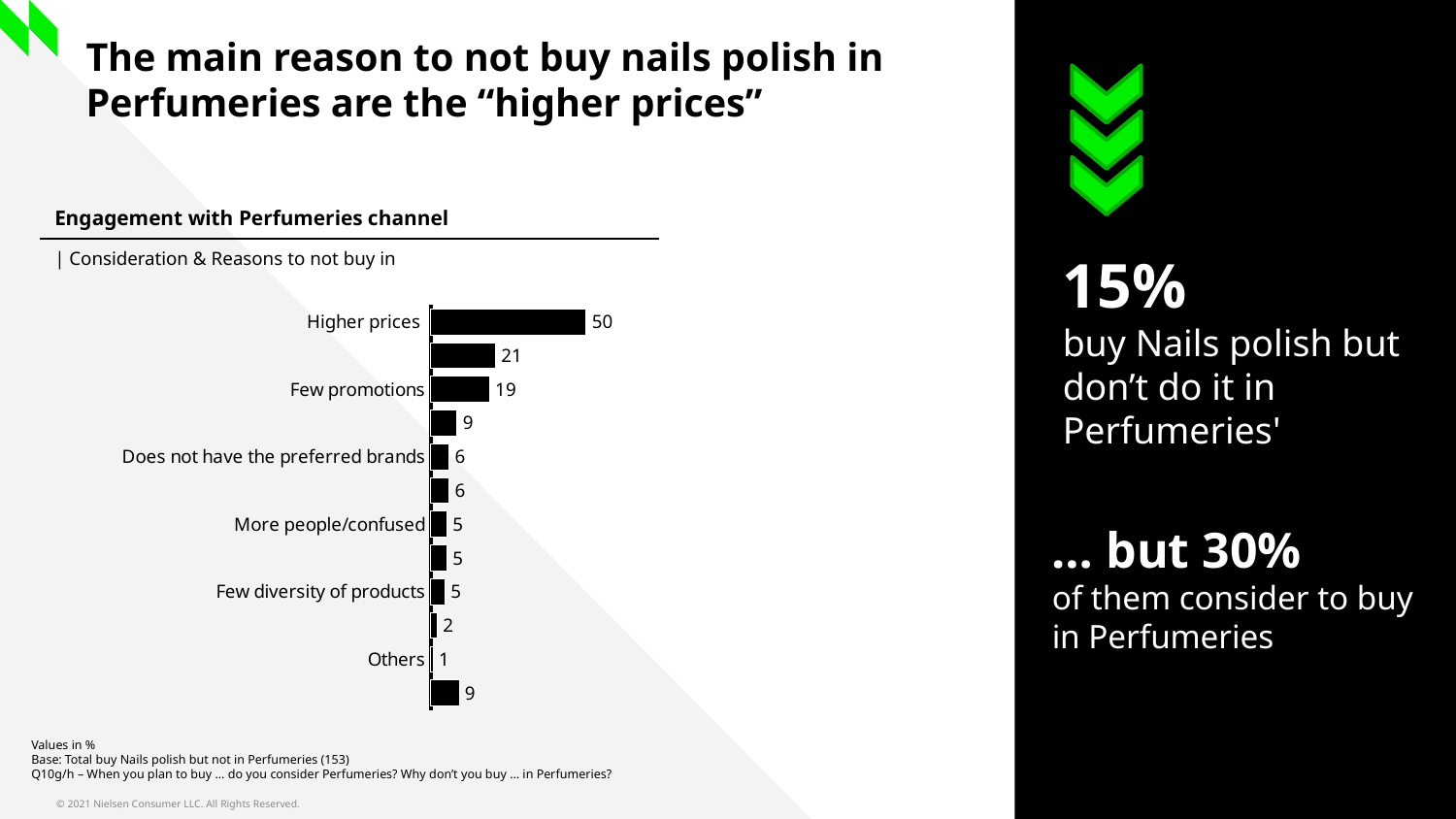
What is the value for "More people/confused" in the chart? 5 Which labelled reason has the lowest value in the chart? Others What is the value for "Higher prices" in the chart? 50 What kind of chart is shown on the slide? Bar chart What is the title shown above the chart? Engagement with Perfumeries channel What is the value for "Few promotions" in the chart? 19 Which reason has the highest value in the chart? Higher prices What is the difference between the values for "Higher prices" and "Few promotions"? 31 What is the value for "Others" in the chart? 1 What is the value for "Does not have the preferred brands" in the chart? 6 How many bars are plotted in the chart? 12 Which has a larger value: "Few promotions" or "Does not have the preferred brands"? Few promotions